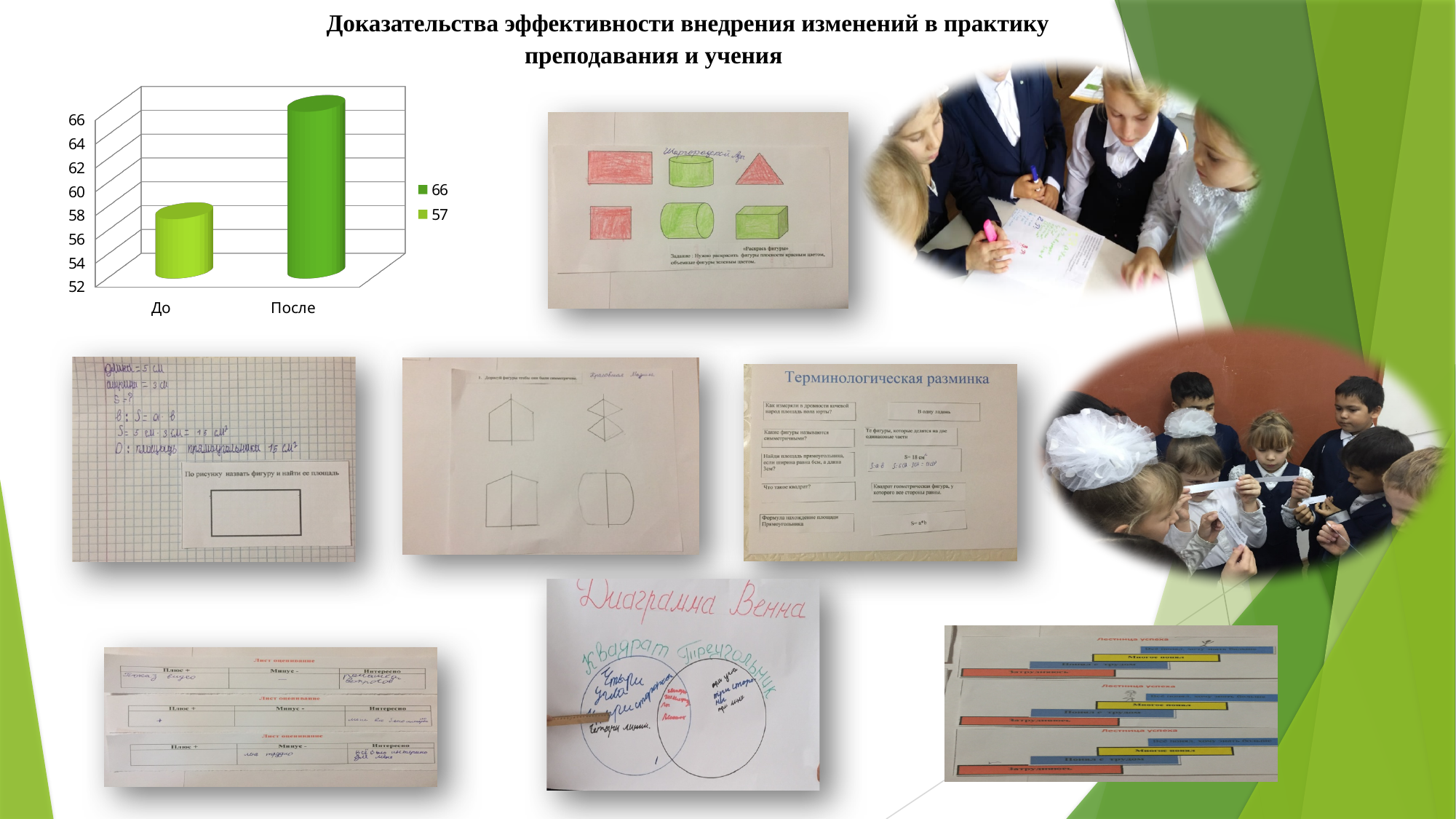
How many entries does the chart legend list? 2 Is the value for До greater or less than 60? less Which category has the higher bar, До or После? После Is the value for После greater or less than 62? greater What are the two entries shown in the chart legend? 66 and 57 Which category has the lowest bar in the chart? До What is the lowest value shown on the vertical axis of the chart? 52 Do the values rise or fall from До to После? rise How many categories are shown on the x axis of the bar chart? 2 Is the value for До greater or less than 54? greater What kind of chart is shown on the slide? bar chart Which category has the highest bar in the chart? После